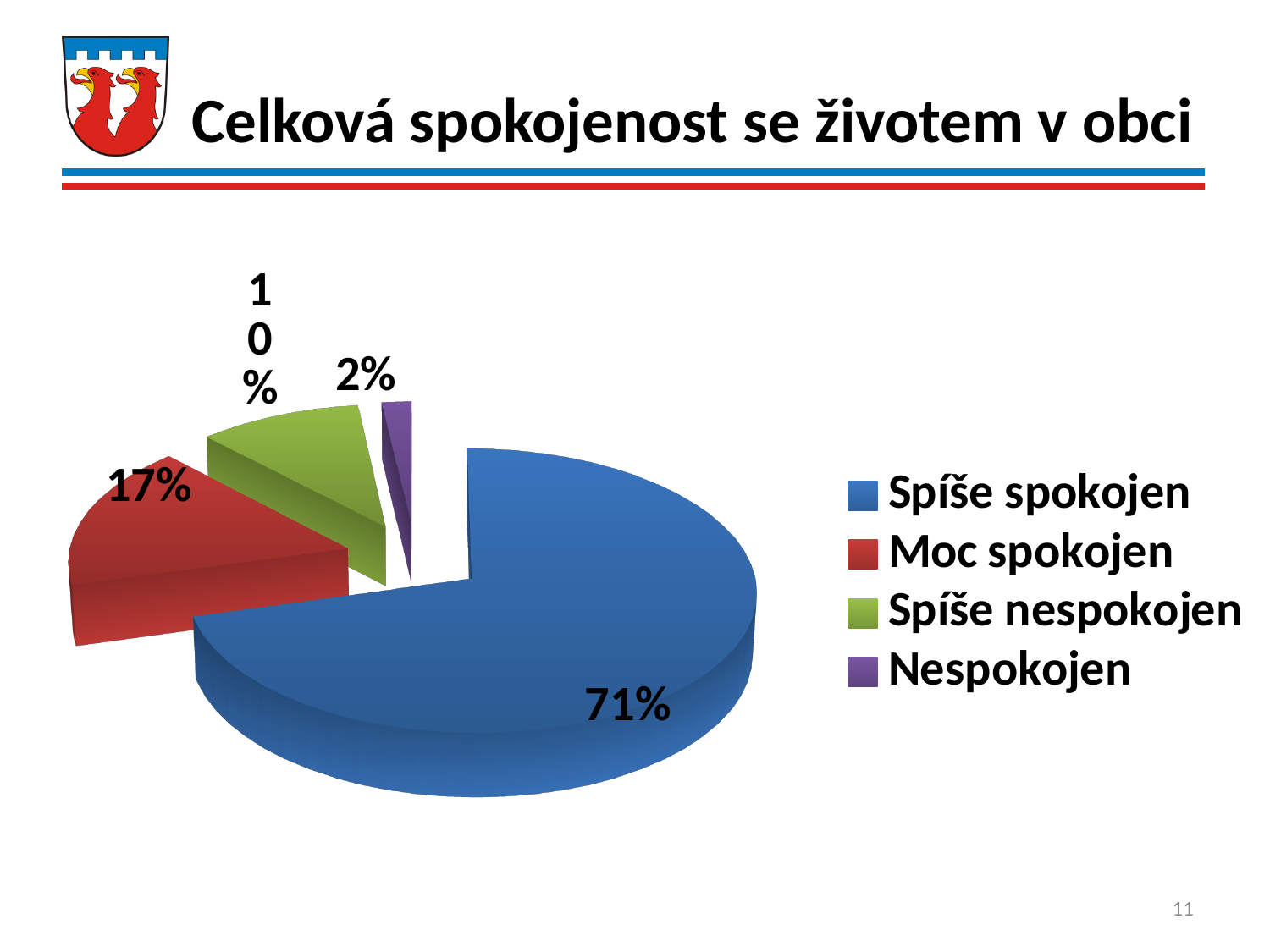
What share of the pie does "Moc spokojen" represent? 17% What is the title of the slide containing the chart? Celková spokojenost se životem v obci What kind of chart is shown on the slide? Pie chart Which colour represents "Nespokojen" in the legend? Purple Which category has the largest slice of the pie? Spíše spokojen What share of the pie does "Spíše spokojen" represent? 71% What share of the pie does "Nespokojen" represent? 2% Which category has the smallest slice of the pie? Nespokojen How many categories does the pie chart show? 4 Which is larger, the slice for "Moc spokojen" or the slice for "Spíše nespokojen"? Moc spokojen What is the difference in percentage points between "Spíše spokojen" and "Moc spokojen"? 54